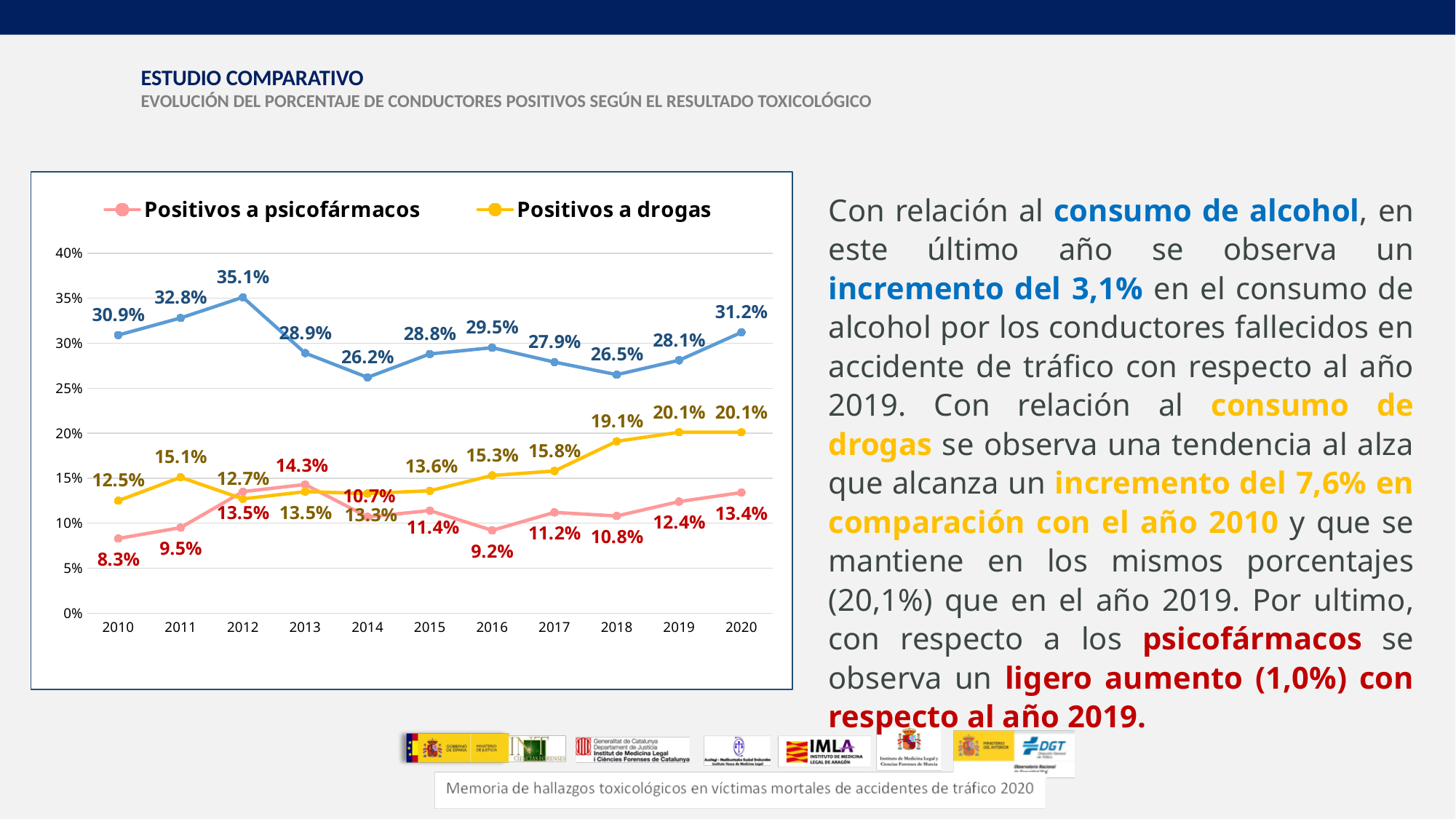
What kind of chart is shown on the slide? Line chart What is the value for Positivos a drogas in 2020? 20.1% What is the difference between Positivos a psicofármacos in 2020 and in 2019? 1.0% In which year is Positivos a psicofármacos highest? 2013 What is the value for Positivos a psicofármacos in 2016? 9.2% In which year is Positivos a drogas lowest? 2010 Does Positivos a drogas rise or fall from 2017 to 2019? Rise How many series does the legend list? 2 What is the value for Positivos a psicofármacos in 2010? 8.3% What is the difference between Positivos a drogas in 2020 and in 2010? 7.6% Which is larger in 2012: Positivos a psicofármacos or Positivos a drogas? Positivos a psicofármacos How many years are shown on the x axis? 11